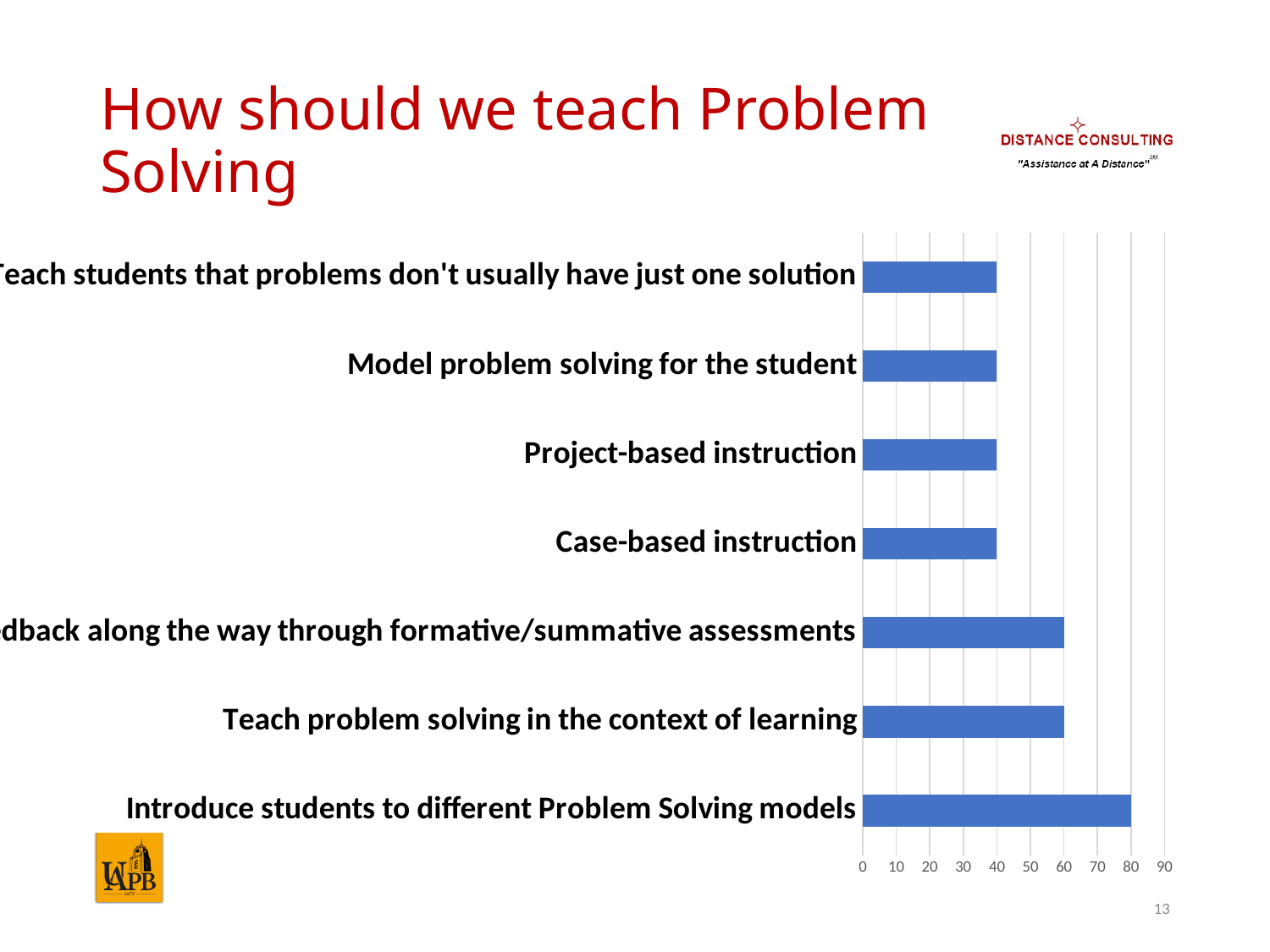
What is the value for "Teach problem solving in the context of learning"? 60 Which is larger, the value for "Teach problem solving in the context of learning" or the value for "Case-based instruction"? Teach problem solving in the context of learning What is the value for "Case-based instruction"? 40 What is the value for "Introduce students to different Problem Solving models"? 80 What is the difference between the values for "Introduce students to different Problem Solving models" and "Project-based instruction"? 40 Which category has the highest value? Introduce students to different Problem Solving models Is the value for "Project-based instruction" greater or less than 50? less What kind of chart is shown on the slide? bar chart What is the difference between the values for "Introduce students to different Problem Solving models" and "Teach problem solving in the context of learning"? 20 What is the value for "Model problem solving for the student"? 40 How many categories are plotted in the chart? 7 What is the title of the slide containing the chart? How should we teach Problem Solving